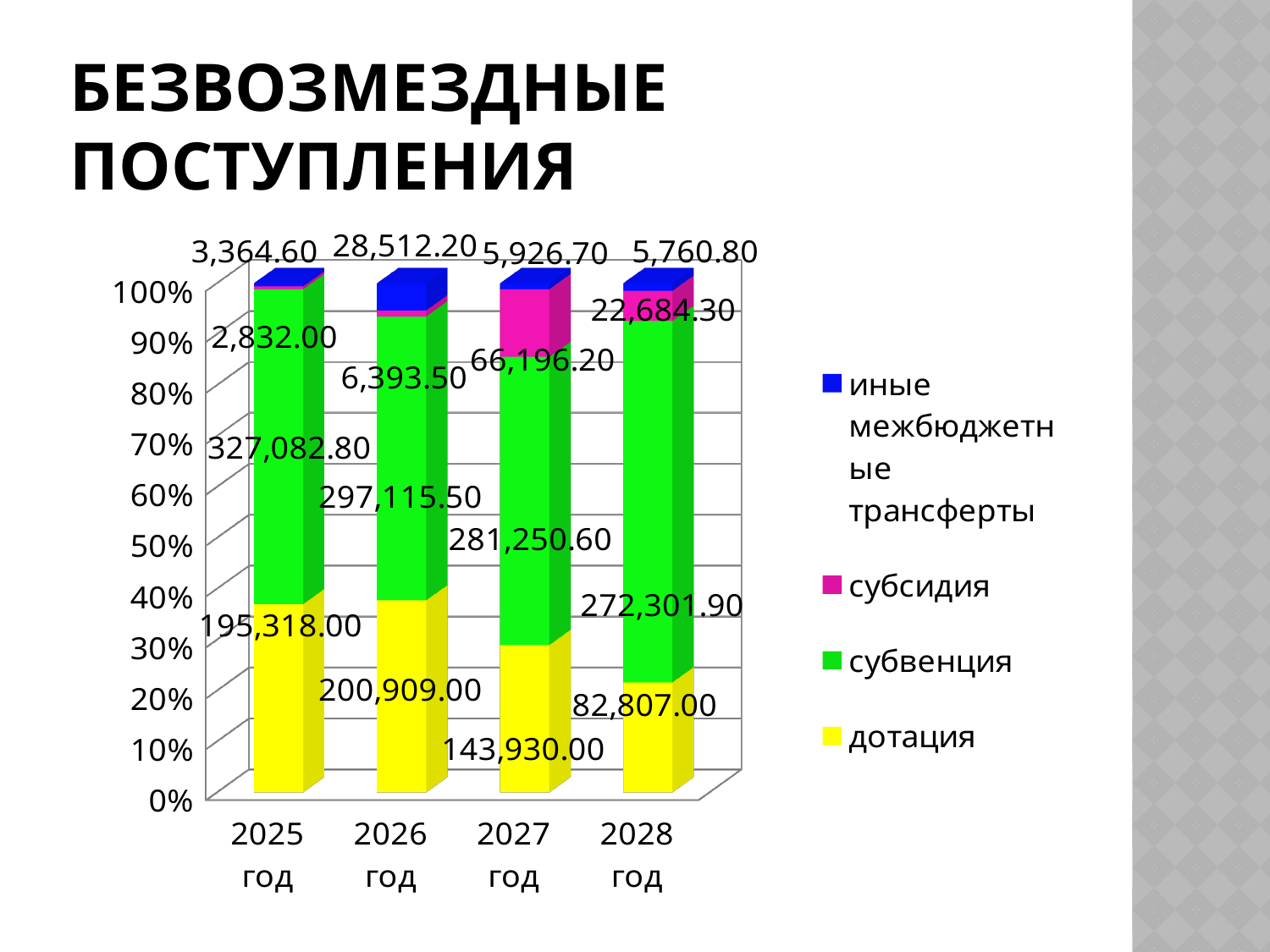
In which year is субсидия the highest? 2027 год What is the value of дотация for 2025 год? 195,318.00 What kind of chart is shown on the slide? stacked bar chart What is the difference between дотация in 2026 год and 2025 год? 5,591.00 Which is larger: субвенция in 2025 год or субвенция in 2028 год? субвенция in 2025 год How many years are shown on the x axis? 4 How many series does the legend list? 4 Does субвенция rise or fall from 2025 год to 2028 год? fall What is the value of иные межбюджетные трансферты for 2026 год? 28,512.20 In which year is дотация the lowest? 2028 год What is the value of субсидия for 2028 год? 22,684.30 What is the value of субвенция for 2027 год? 281,250.60